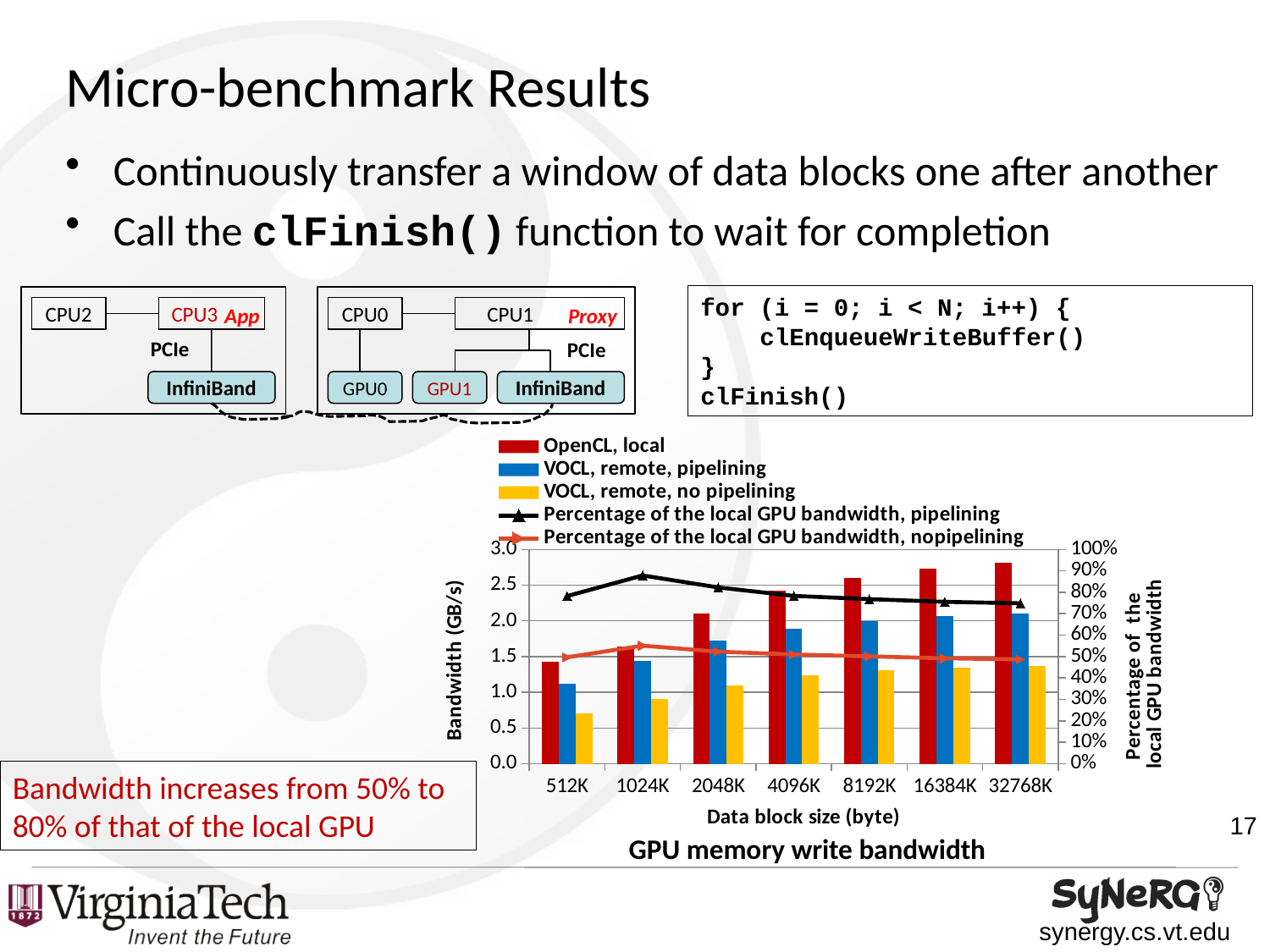
For which data block size is the 'OpenCL, local' bandwidth highest? 32768K What is the label of the left vertical axis of the chart? Bandwidth (GB/s) Is the 'OpenCL, local' bandwidth at 32768K greater or less than 2.5 GB/s? greater At 512K, which is larger: the 'OpenCL, local' bandwidth or the 'VOCL, remote, no pipelining' bandwidth? OpenCL, local What is the title of the chart on the slide? GPU memory write bandwidth How many data block size categories are shown on the x axis of the chart? 7 How many series does the chart's legend list? 5 What kind of chart is shown on the slide? Combined bar and line chart Is the 'VOCL, remote, no pipelining' bandwidth at 512K greater or less than 1.0 GB/s? less Is the 'Percentage of the local GPU bandwidth, pipelining' value at 1024K greater or less than 80%? greater For which data block size is the 'VOCL, remote, no pipelining' bandwidth lowest? 512K Does the 'OpenCL, local' bandwidth rise or fall as the data block size increases along the x axis? rise